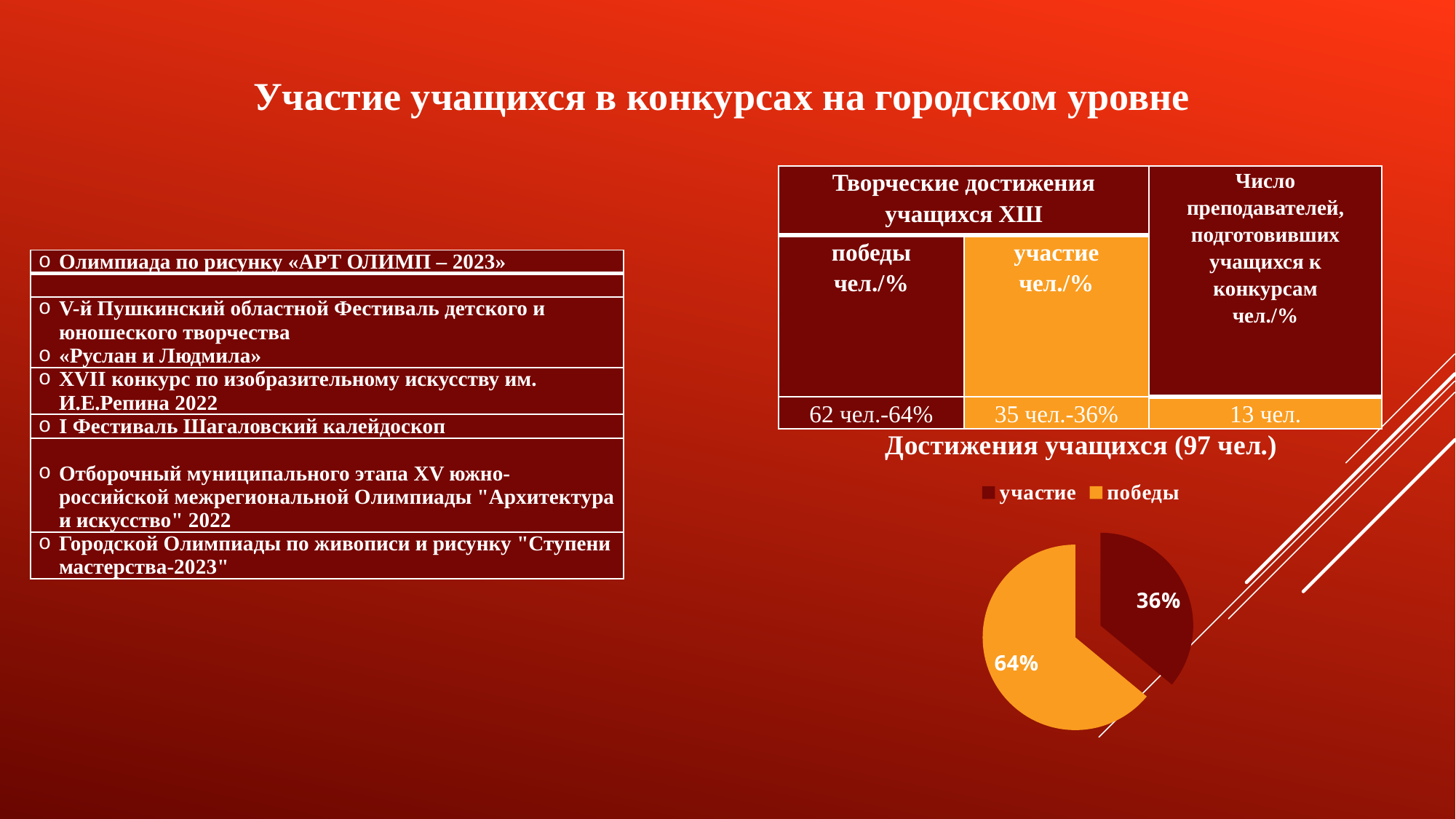
Which slice of the pie chart is the largest? победы What share of the pie does the "участие" slice represent? 36% What is the title of the pie chart? Достижения учащихся (97 чел.) How many entries does the pie chart's legend list? 2 How many slices does the pie chart have? 2 In the pie chart, which is larger: "победы" or "участие"? победы By how many percentage points does the "победы" slice exceed the "участие" slice in the pie chart? 28 Which slice of the pie chart is the smallest? участие What colour is the "победы" slice in the pie chart? orange What kind of chart is shown under the heading "Достижения учащихся (97 чел.)"? pie chart What percentage is shown for the "участие" slice of the pie chart? 36% What percentage is shown for the "победы" slice of the pie chart? 64%